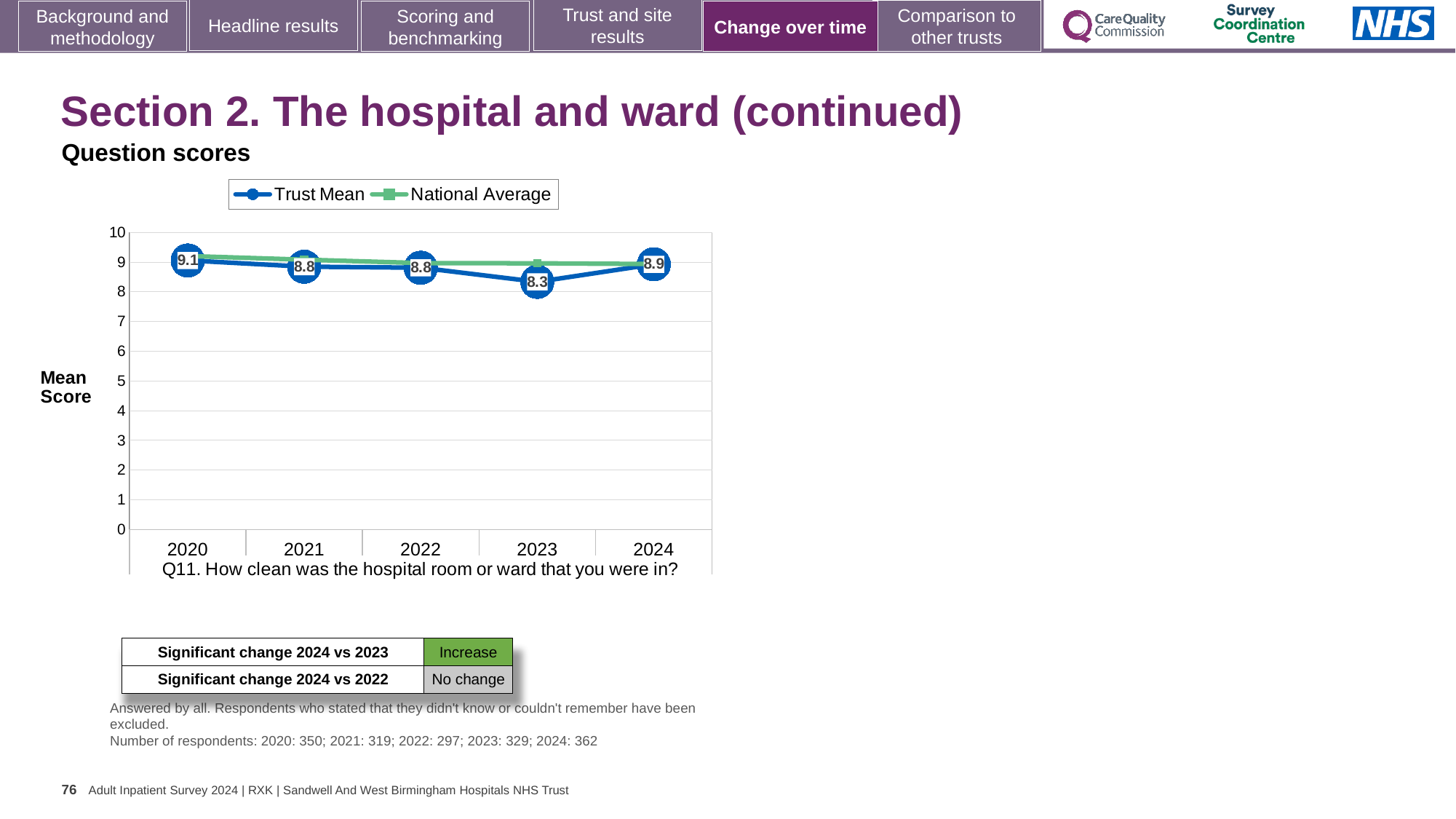
What kind of chart is shown on the slide? Line chart Which is larger, the Trust Mean score for 2020 or for 2023? 2020 In which year is the Trust Mean score lowest? 2023 How many series does the chart legend list? 2 In which year is the Trust Mean score highest? 2020 What is the Trust Mean score for 2023? 8.3 Is the National Average for 2023 greater or less than 8? greater What is the Trust Mean score for 2024? 8.9 What is the Trust Mean score for 2020? 9.1 Which question does the chart show scores for? Q11. How clean was the hospital room or ward that you were in? What is the difference between the Trust Mean scores for 2024 and 2023? 0.6 How many years are shown on the x axis of the chart? 5